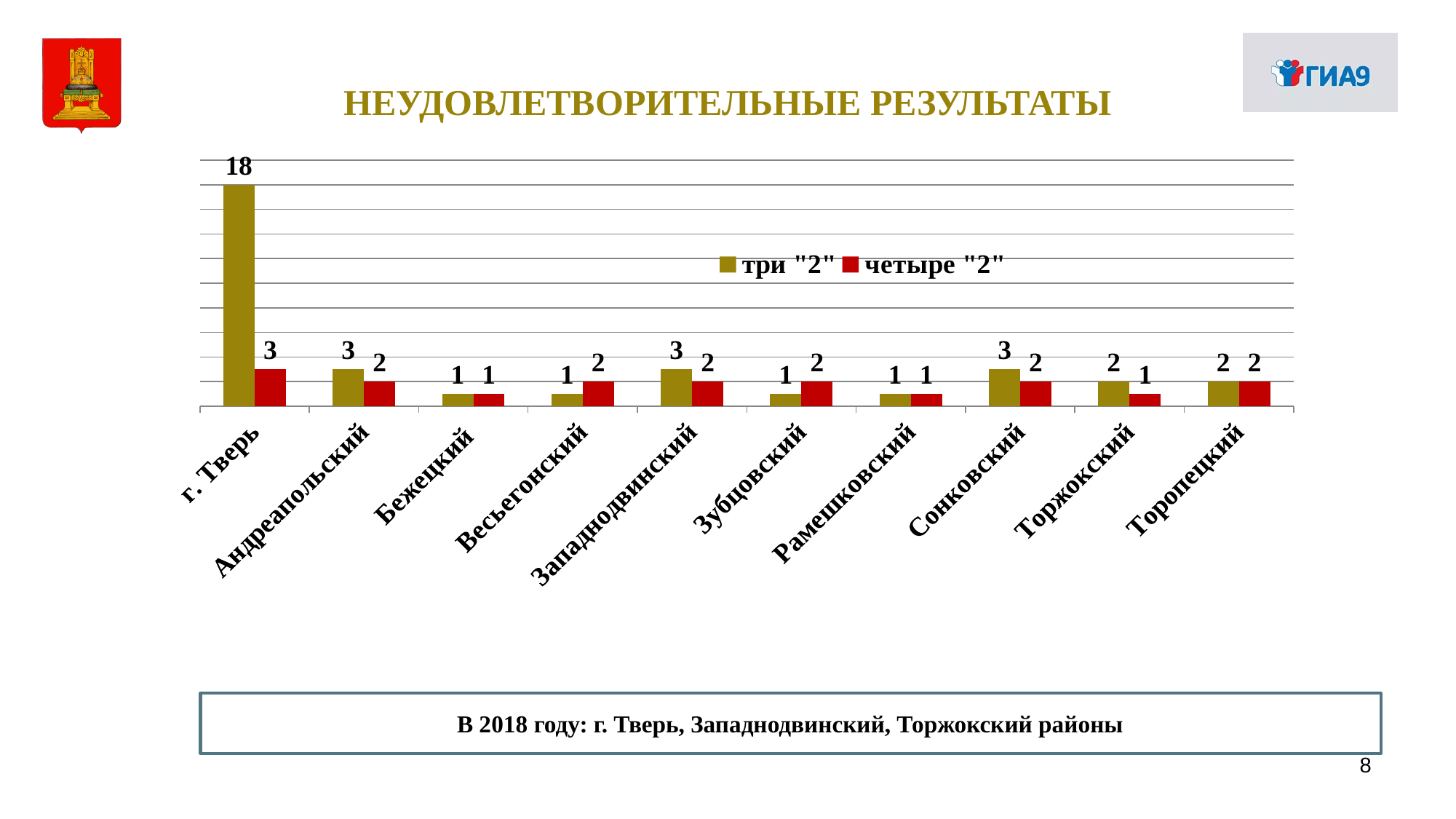
How many series does the legend list? 2 Which category has the highest value in the четыре "2" series? г. Тверь Which is larger for Зубцовский: the три "2" value or the четыре "2" value? четыре "2" What is the title of the slide above the chart? НЕУДОВЛЕТВОРИТЕЛЬНЫЕ РЕЗУЛЬТАТЫ Which category has the highest value in the три "2" series? г. Тверь What is the difference between the три "2" and четыре "2" values for г. Тверь? 15 How many categories are shown on the x axis of the chart? 10 What is the value of the четыре "2" series for Весьегонский? 2 What kind of chart is shown on the slide? bar chart What is the value of the три "2" series for г. Тверь? 18 Which is larger for Торжокский: the три "2" value or the четыре "2" value? три "2" What is the value of the три "2" series for Сонковский? 3